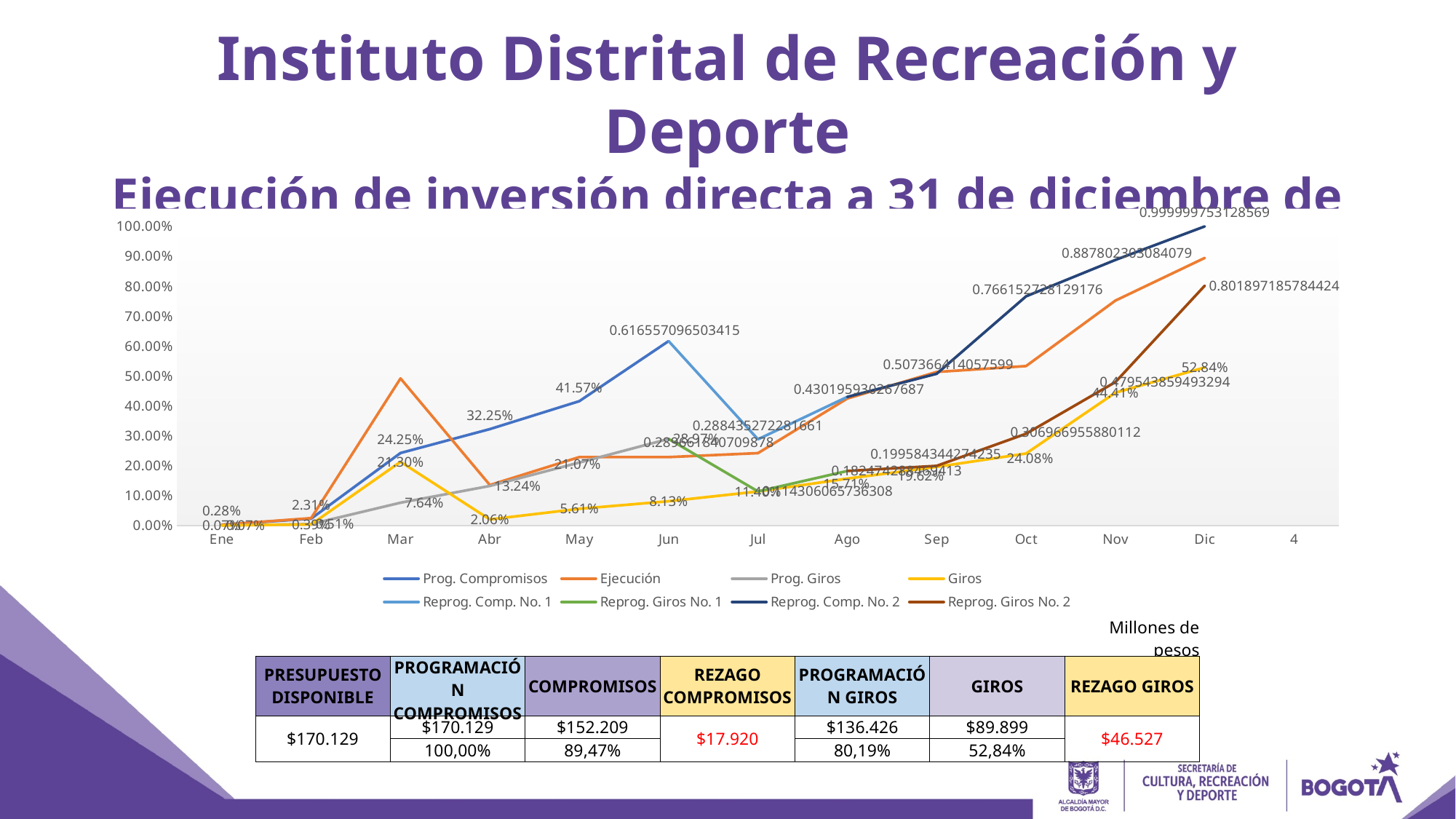
What is the data label for the Reprog. Comp. No. 2 series at Dic? 0.999999753128569 What is the data label for the Reprog. Giros No. 2 series at Dic? 0.801897185784424 How many series does the chart legend list? 8 What kind of chart is shown on the slide? line chart At Dic, which is higher: Reprog. Comp. No. 2 or Reprog. Giros No. 2? Reprog. Comp. No. 2 What is the value of the Giros series at Dic? 52.84% Is the value of the Ejecución series at Dic greater or less than 80%? greater What is the value of the Giros series at Nov? 44.41% What is the value of the Prog. Compromisos series at Mar? 24.25% What is the data label for the Reprog. Comp. No. 1 series at Jun? 0.616557096503415 What is the value of the Prog. Compromisos series at May? 41.57% By how many percentage points did the Giros series increase from Nov to Dic? 8.43